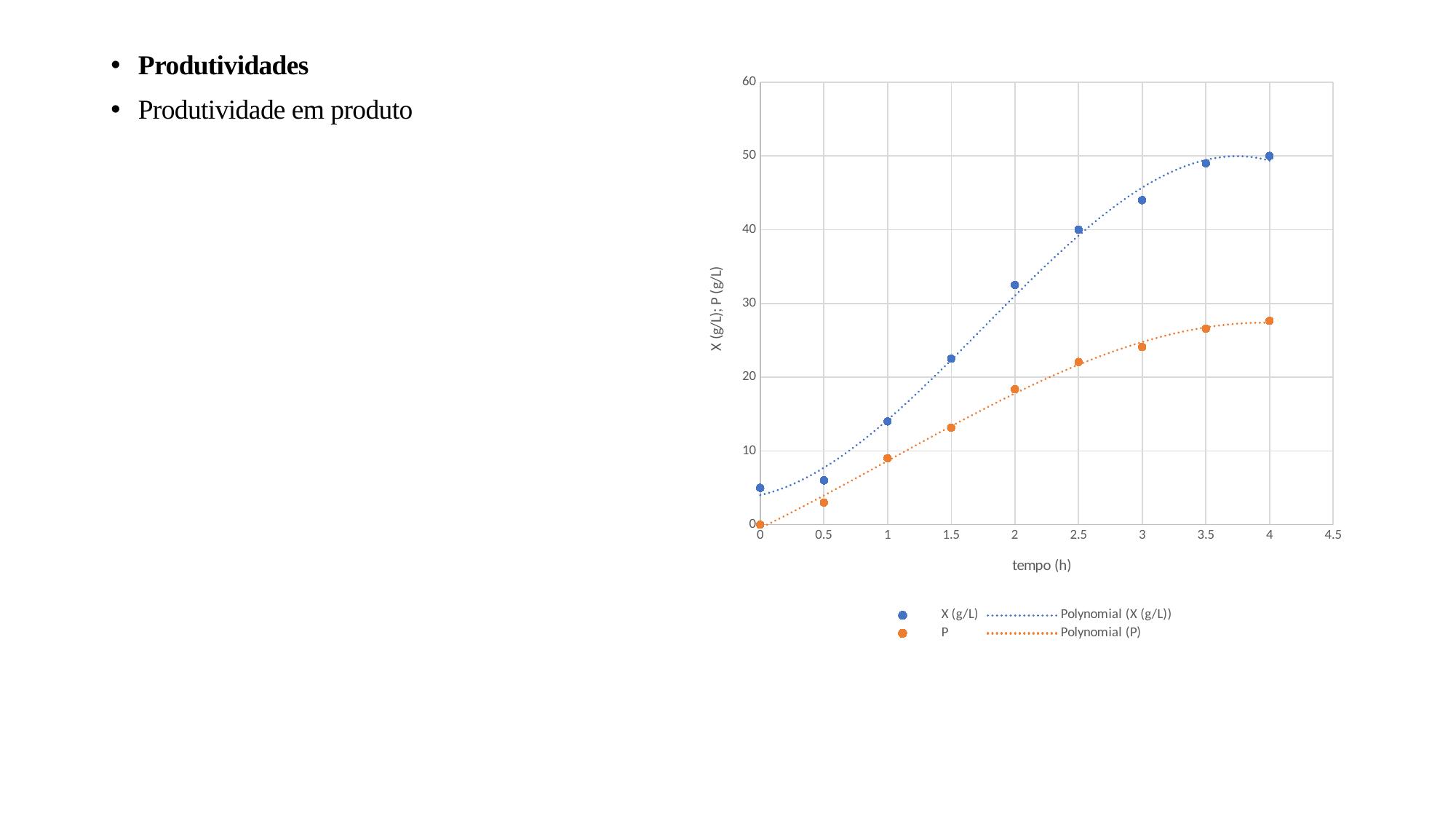
Is the value of P at tempo 2 h greater or less than 20? less Is the value of P at tempo 4 h greater or less than 30? less Is the value of X (g/L) at tempo 2 h greater or less than 30? greater What is the value of P at tempo 0 h? 0 Do the values of the P series rise or fall as tempo increases? Rise At which tempo is the P series at its lowest value? 0 What is the title of the x axis of the chart? tempo (h) How many data points are plotted for the X (g/L) series? 9 What kind of chart is shown on the slide? Scatter chart How many entries does the chart legend list? 4 At tempo 2.5 h, which series has the larger value, X (g/L) or P? X (g/L)